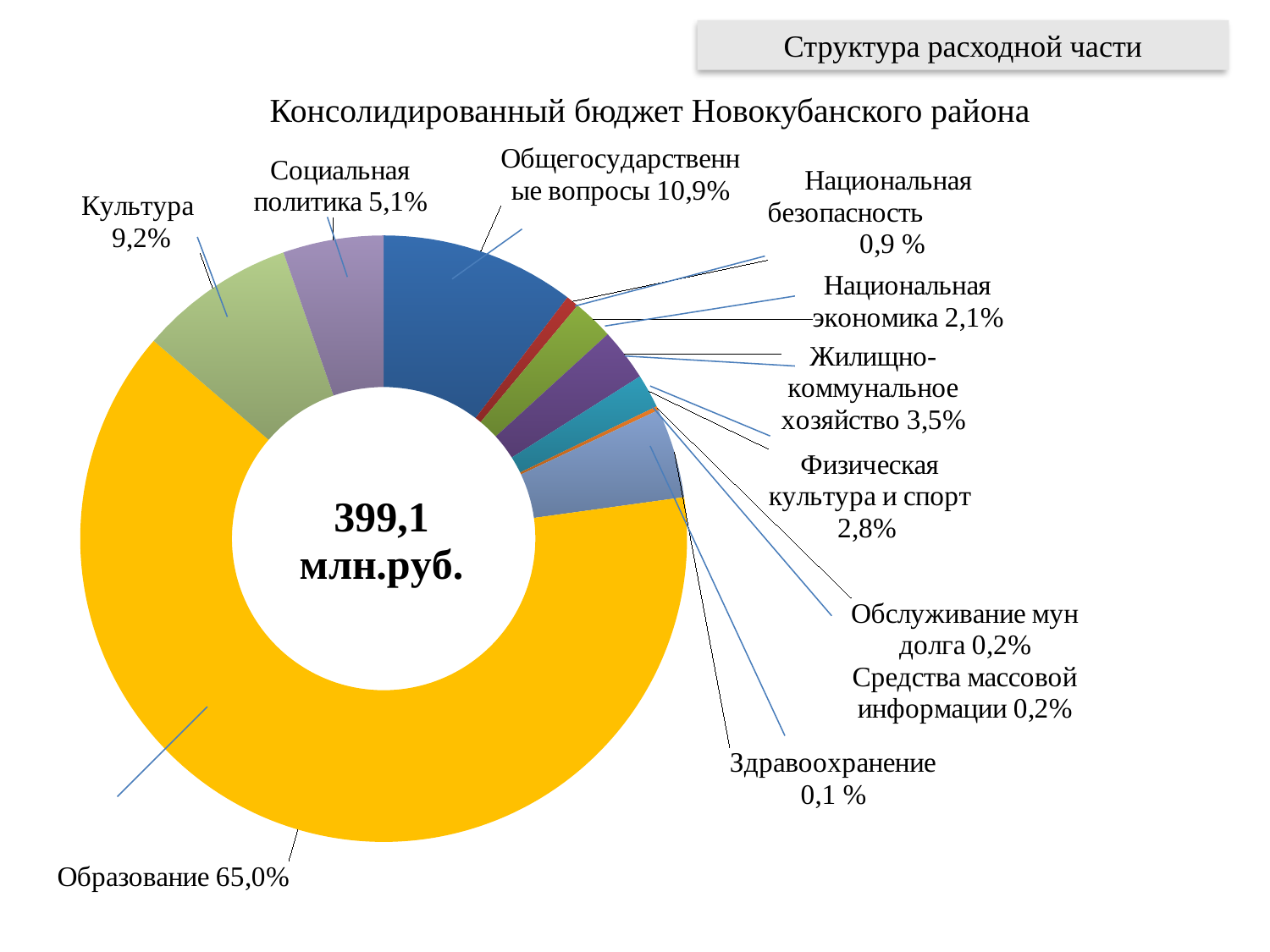
What kind of chart is shown on the slide? doughnut chart Which category has the largest share of the budget? Образование Which is larger, the share for Национальная экономика or the share for Национальная безопасность? Национальная экономика What percentage is labelled for Жилищно-коммунальное хозяйство? 3,5% What share of the budget goes to Образование? 65,0% What share is shown for Общегосударственные вопросы? 10,9% What is the title of the chart? Консолидированный бюджет Новокубанского района What total amount is written in the centre of the chart? 399,1 млн.руб. What share is shown for Физическая культура и спорт? 2,8% What is the difference in percentage points between Культура and Социальная политика? 4,1 Which category has the smallest share of the budget? Здравоохранение How many categories are shown in the chart? 11